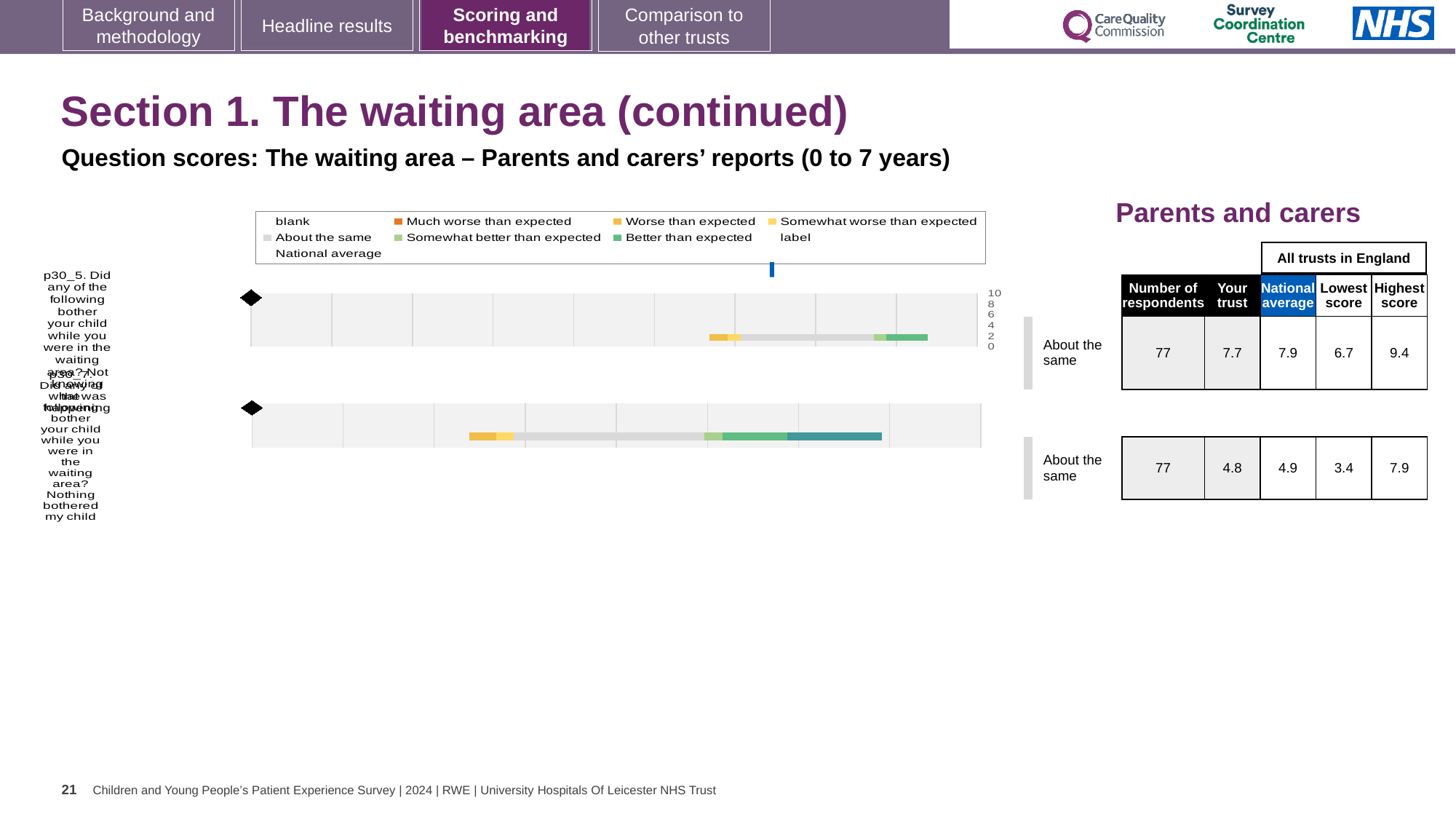
How many question bars are plotted in the chart? 2 What is the difference between the highest score (9.4) and the lowest score (6.7) for the first row (p30_5)? 2.7 Which is larger for the first row (p30_5): the trust's score or the national average? national average In the table, what is the 'Your trust' score for question p30_5 (the first row)? 7.7 In the table, what is the lowest score across all trusts in England for the second row (p30_7)? 3.4 In the table, what is the highest score across all trusts in England for the first row (p30_5)? 9.4 In the table, what is the 'Your trust' score for question p30_7 (the second row)? 4.8 In the table, what is the national average for the first row (p30_5)? 7.9 How many respondents are listed for each question in the table? 77 Which legend entry is shown in orange? Much worse than expected What kind of chart is shown on the slide? bar chart What is the highest value shown on the chart's numeric axis? 10